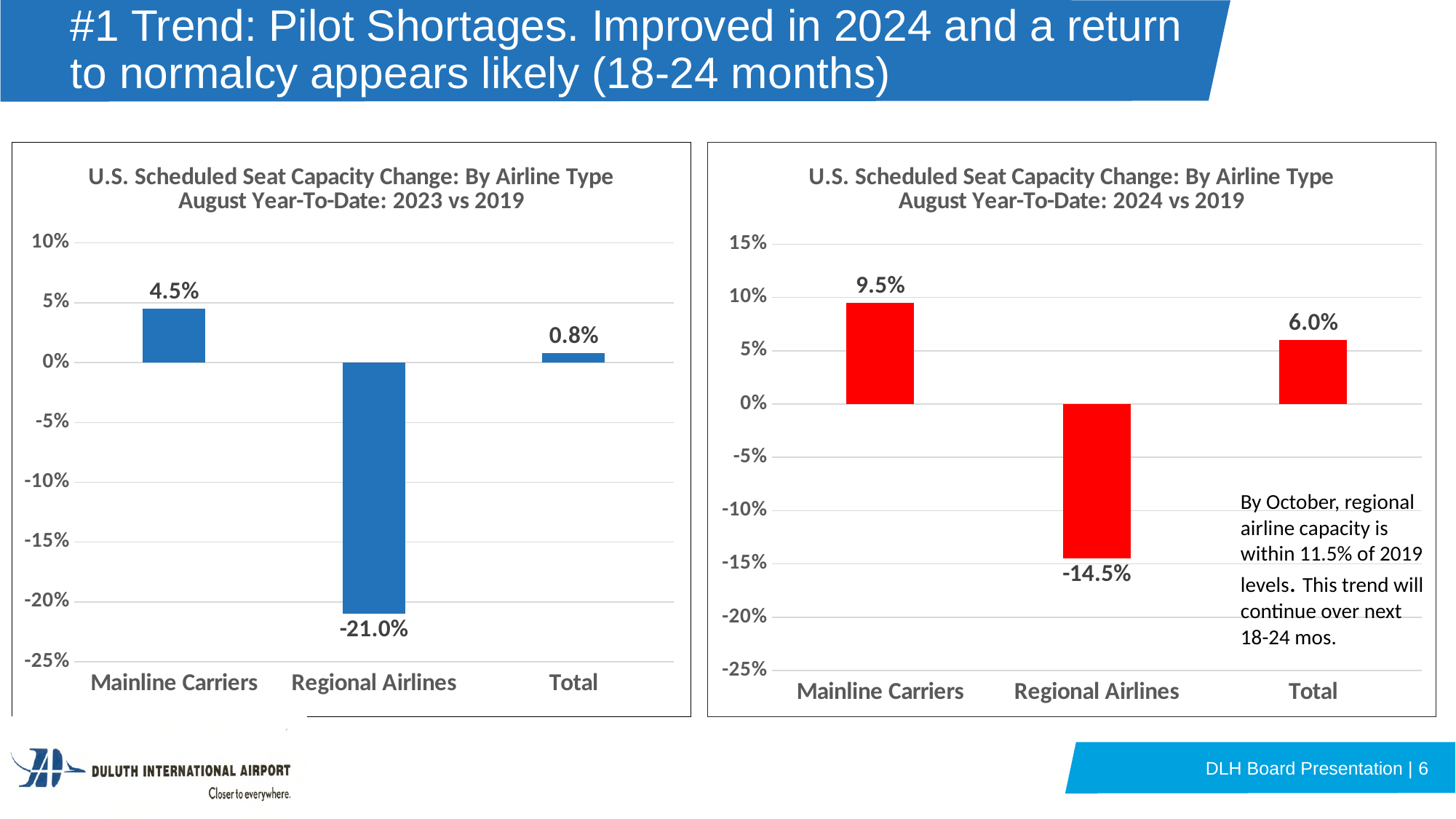
Is the Mainline Carriers value larger in the left chart (2023 vs 2019) or the right chart (2024 vs 2019)? Right chart (2024 vs 2019) In the right chart (2024 vs 2019), what is the value for Total? 6.0% In the left chart (2023 vs 2019), which category has the lowest value? Regional Airlines In the right chart (2024 vs 2019), what is the value for Mainline Carriers? 9.5% In the right chart (2024 vs 2019), which category has the highest value? Mainline Carriers In the left chart (2023 vs 2019), what is the value for Total? 0.8% In the right chart (2024 vs 2019), what is the value for Regional Airlines? -14.5% In the left chart (2023 vs 2019), what is the value for Mainline Carriers? 4.5% In the right chart (2024 vs 2019), what is the difference between the Mainline Carriers value and the Total value? 3.5% In the left chart (2023 vs 2019), what is the value for Regional Airlines? -21.0% How many categories are shown in the left chart (2023 vs 2019)? 3 What kind of chart is the right chart (2024 vs 2019)? Bar chart